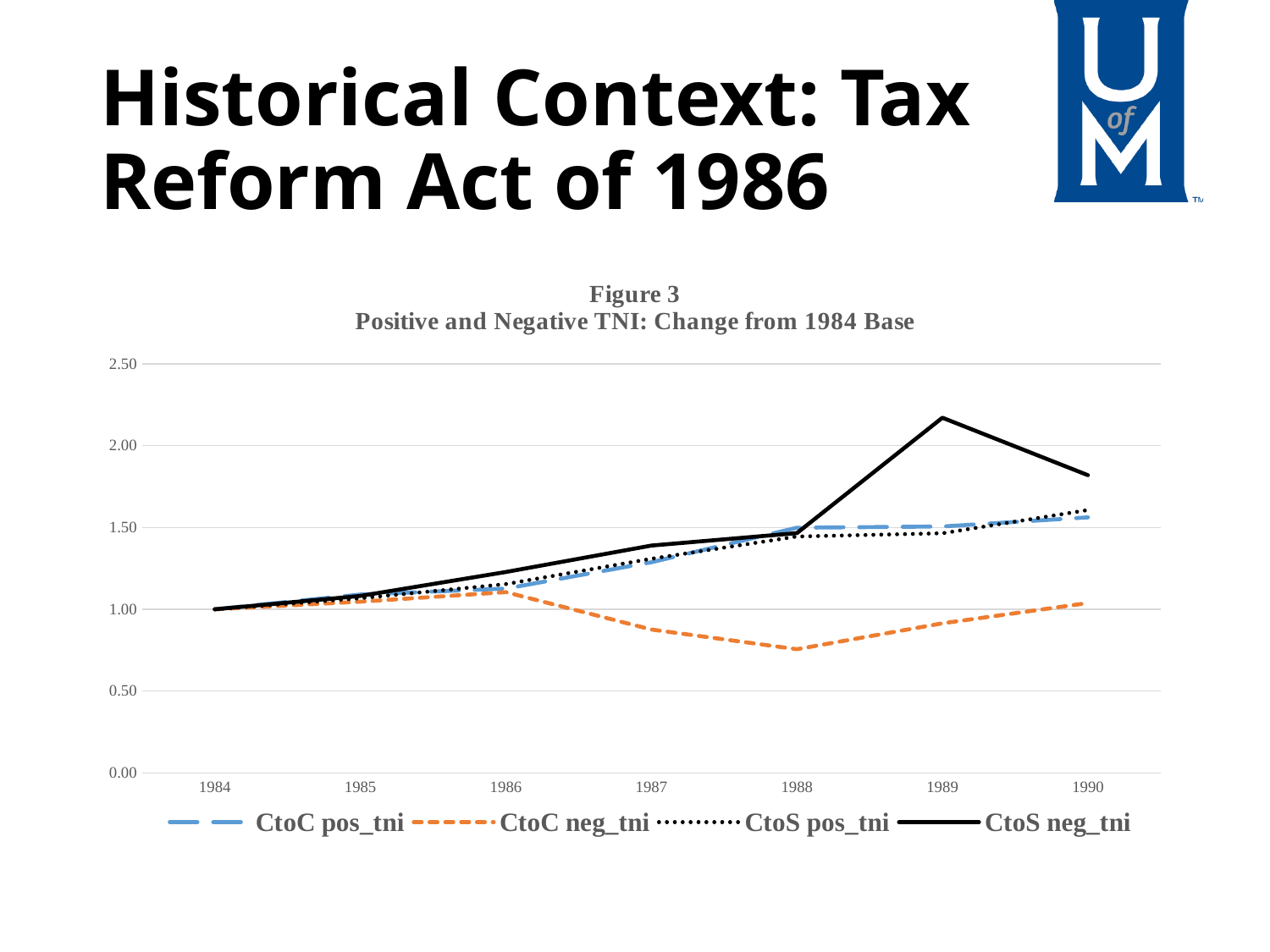
Does the CtoS neg_tni series rise or fall from 1989 to 1990? fall How many series does the legend list? 4 Is the value for CtoS neg_tni in 1989 greater or less than 2.00? greater What is the value of CtoS neg_tni in 1984? 1.00 Which series has the highest value in 1989? CtoS neg_tni In 1990, which is larger: CtoS neg_tni or CtoC neg_tni? CtoS neg_tni Is the value for CtoC neg_tni in 1988 greater or less than 1.00? less How many years are shown along the x axis? 7 Which series has the lowest value in 1990? CtoC neg_tni What is the title of the chart? Figure 3 Positive and Negative TNI: Change from 1984 Base Does the CtoC neg_tni series rise or fall from 1986 to 1988? fall What kind of chart is shown on the slide? line chart